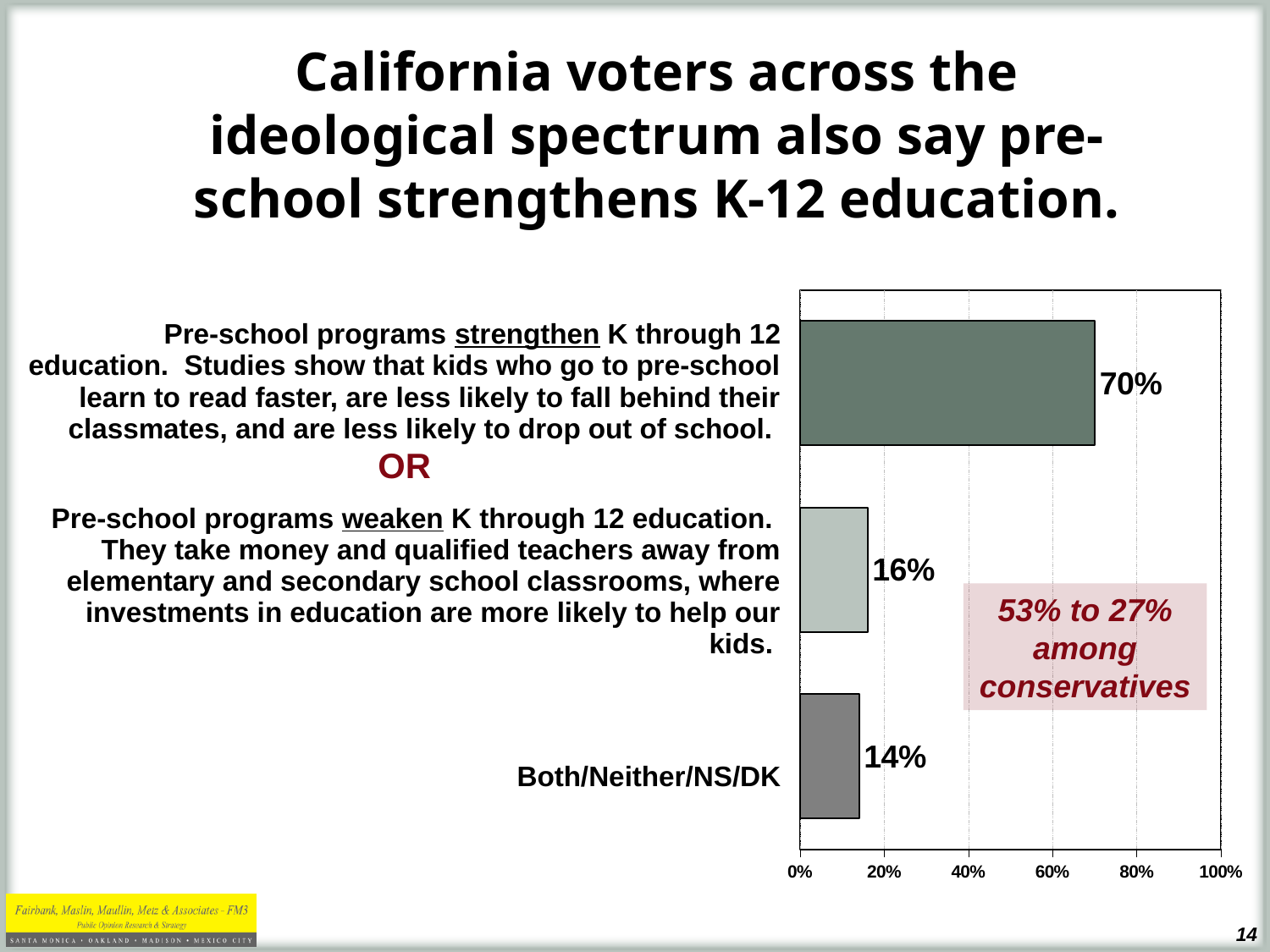
How many categories are shown in the chart? 3 What is the difference between the 'strengthen' and 'weaken' percentages? 54% Which category has the lowest value? Both/Neither/NS/DK What percentage of voters say pre-school programs strengthen K through 12 education? 70% What is the value for the Both/Neither/NS/DK category? 14% What kind of chart is shown on the slide? bar chart Which is larger, the 'strengthen' value or the 'weaken' value? strengthen What is the difference between the 'weaken' percentage and the Both/Neither/NS/DK percentage? 2% What is the maximum value shown on the x axis? 100% Is the value for 'strengthen' greater or less than 60%? greater What percentage of voters say pre-school programs weaken K through 12 education? 16% Which category has the highest value? Pre-school programs strengthen K through 12 education